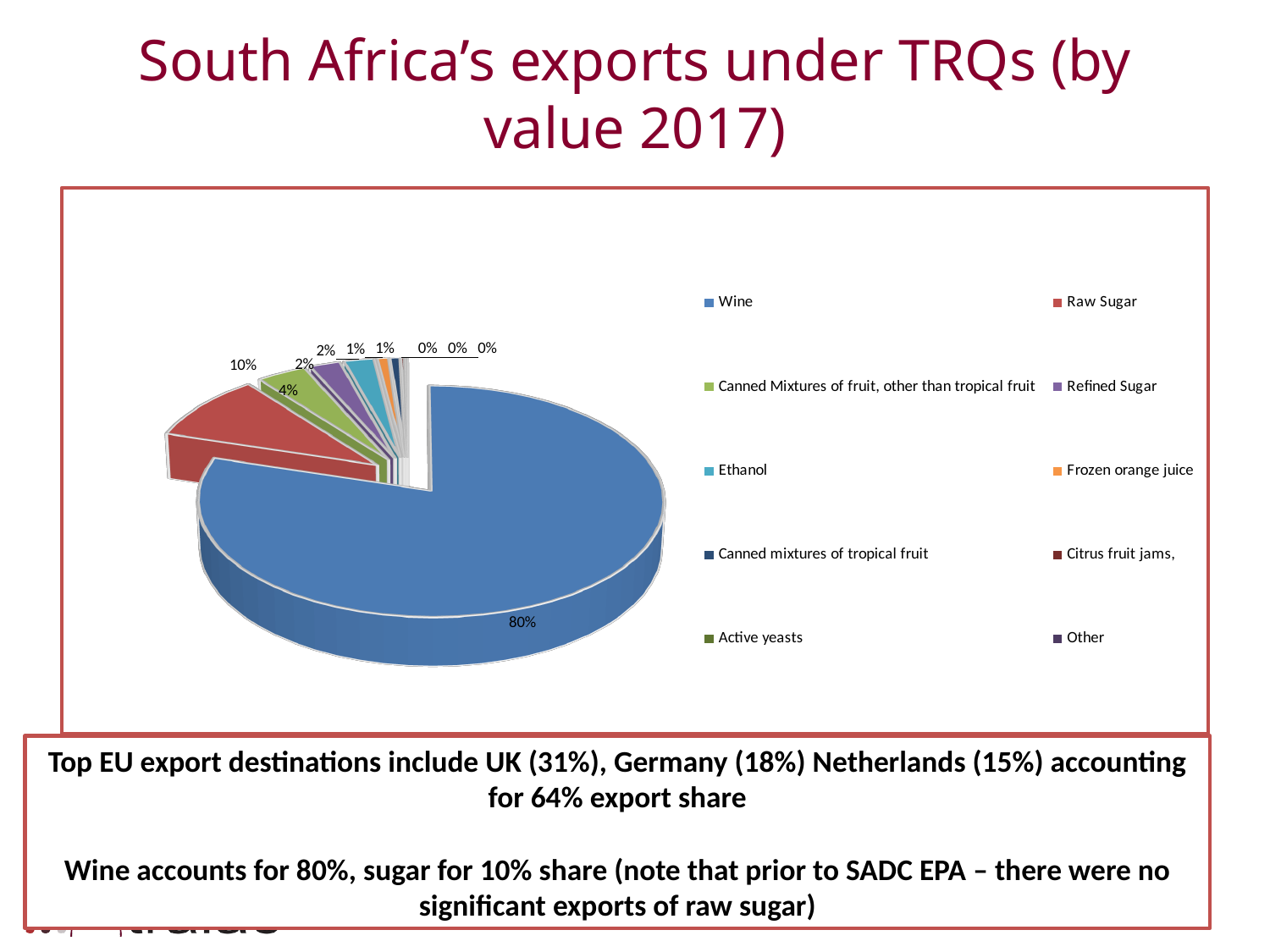
Which category has the largest share of the pie? Wine What is the combined share of Wine and Raw Sugar? 90% What colour is the Wine slice in the pie chart? Blue What share of the pie does Raw Sugar account for? 10% What is the title of the chart on the slide? South Africa's exports under TRQs (by value 2017) What share of the pie does Canned Mixtures of fruit, other than tropical fruit account for? 4% What share of the pie does Wine account for? 80% How many categories does the legend list? 10 What kind of chart is shown on the slide? Pie chart Which is larger, the share for Raw Sugar or the share for Canned Mixtures of fruit, other than tropical fruit? Raw Sugar What is the difference in percentage points between the Wine share and the Raw Sugar share? 70 percentage points Which is larger, the share for Wine or the share for Raw Sugar? Wine